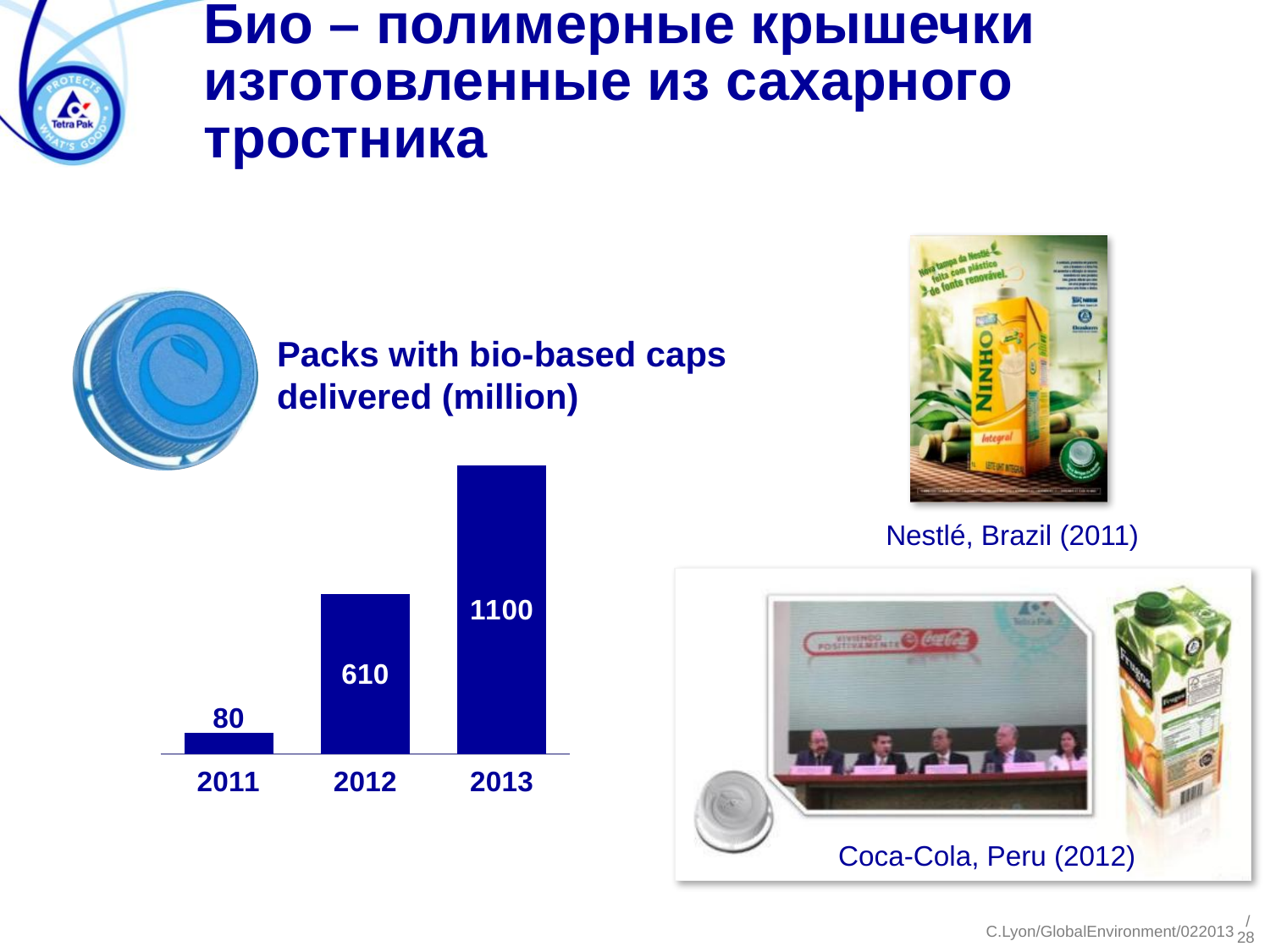
What kind of chart is used to show packs with bio-based caps delivered? Bar chart What value is shown for 2011 in the chart of packs with bio-based caps delivered? 80 What is the difference between the 2012 and 2011 values in the chart of packs with bio-based caps delivered? 530 How many years are shown in the chart of packs with bio-based caps delivered? 3 Which year has the lowest value in the chart of packs with bio-based caps delivered? 2011 What value is shown for 2013 in the chart of packs with bio-based caps delivered? 1100 What is the difference between the 2013 and 2012 values in the chart of packs with bio-based caps delivered? 490 Which is larger in the chart of packs with bio-based caps delivered: the value for 2012 or the value for 2013? 2013 What value is shown for 2012 in the chart of packs with bio-based caps delivered? 610 In what unit are the values in the chart of packs with bio-based caps delivered expressed? Million Which year has the highest value in the chart of packs with bio-based caps delivered? 2013 Do the values in the chart of packs with bio-based caps delivered rise or fall from 2011 to 2013? Rise